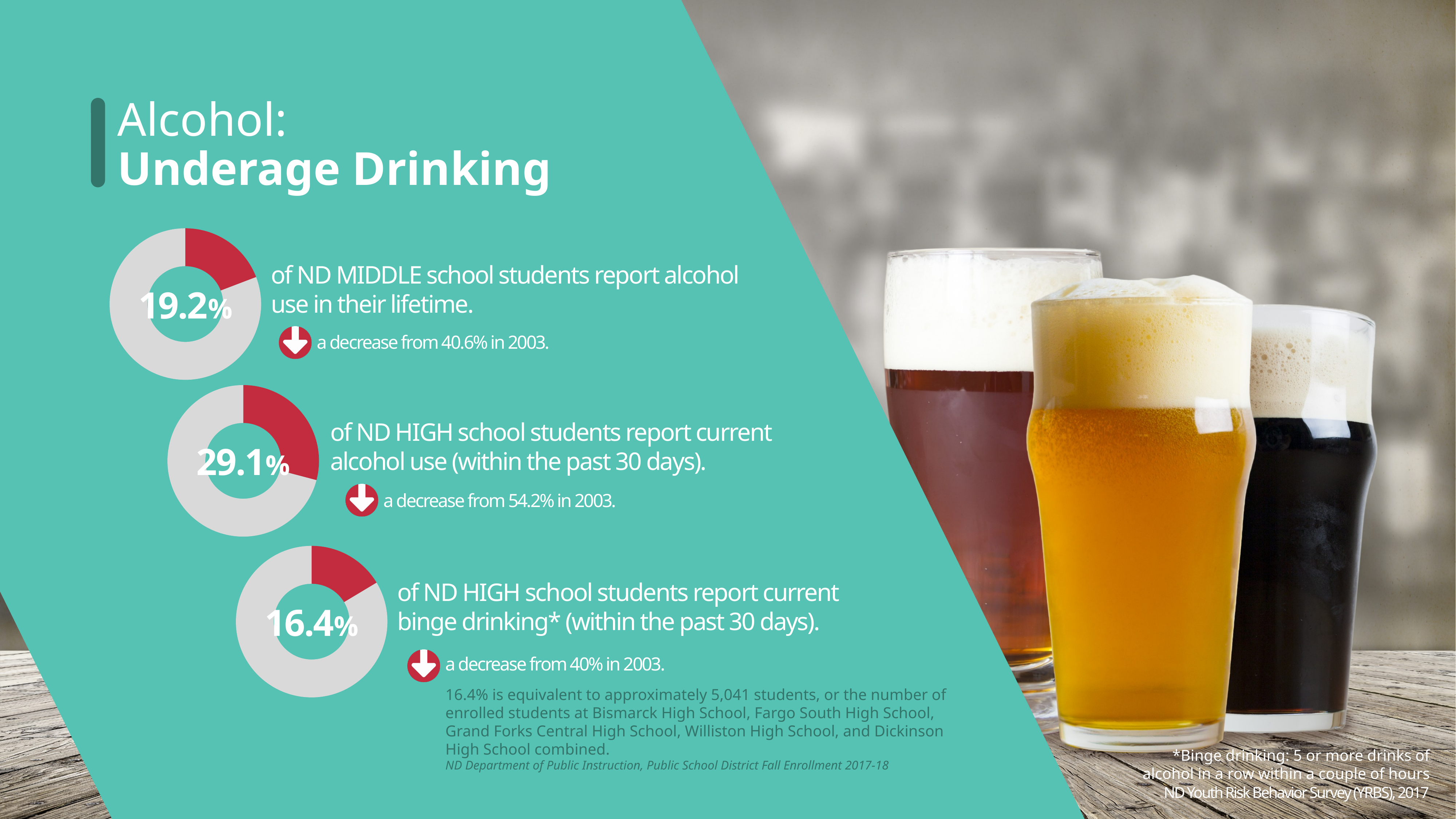
What percentage of ND middle school students report alcohol use in their lifetime, according to the top donut chart? 19.2% What colour is used for the filled (highlighted) portion of each donut chart? Red Which of the three donut charts shows the lowest percentage? ND high school students reporting current binge drinking (16.4%) Did the percentage of ND high school students reporting current alcohol use increase or decrease from 2003 (54.2%) to the value shown in the middle donut chart? Decrease Which of the three donut charts shows the highest percentage? ND high school students reporting current alcohol use (29.1%) How many donut charts are shown on the slide? 3 What percentage of ND high school students report current alcohol use (within the past 30 days), according to the middle donut chart? 29.1% According to the slide, what was the percentage of ND middle school students reporting lifetime alcohol use in 2003? 40.6% What percentage of ND high school students report current binge drinking, according to the bottom donut chart? 16.4% Which is larger: the percentage of ND middle school students reporting lifetime alcohol use or the percentage of ND high school students reporting current binge drinking? ND middle school students reporting lifetime alcohol use (19.2%) What kind of chart is used to display the three percentages on the slide? Donut (pie) chart What is the difference between the current alcohol use percentage (29.1%) and the current binge drinking percentage (16.4%) for ND high school students? 12.7%